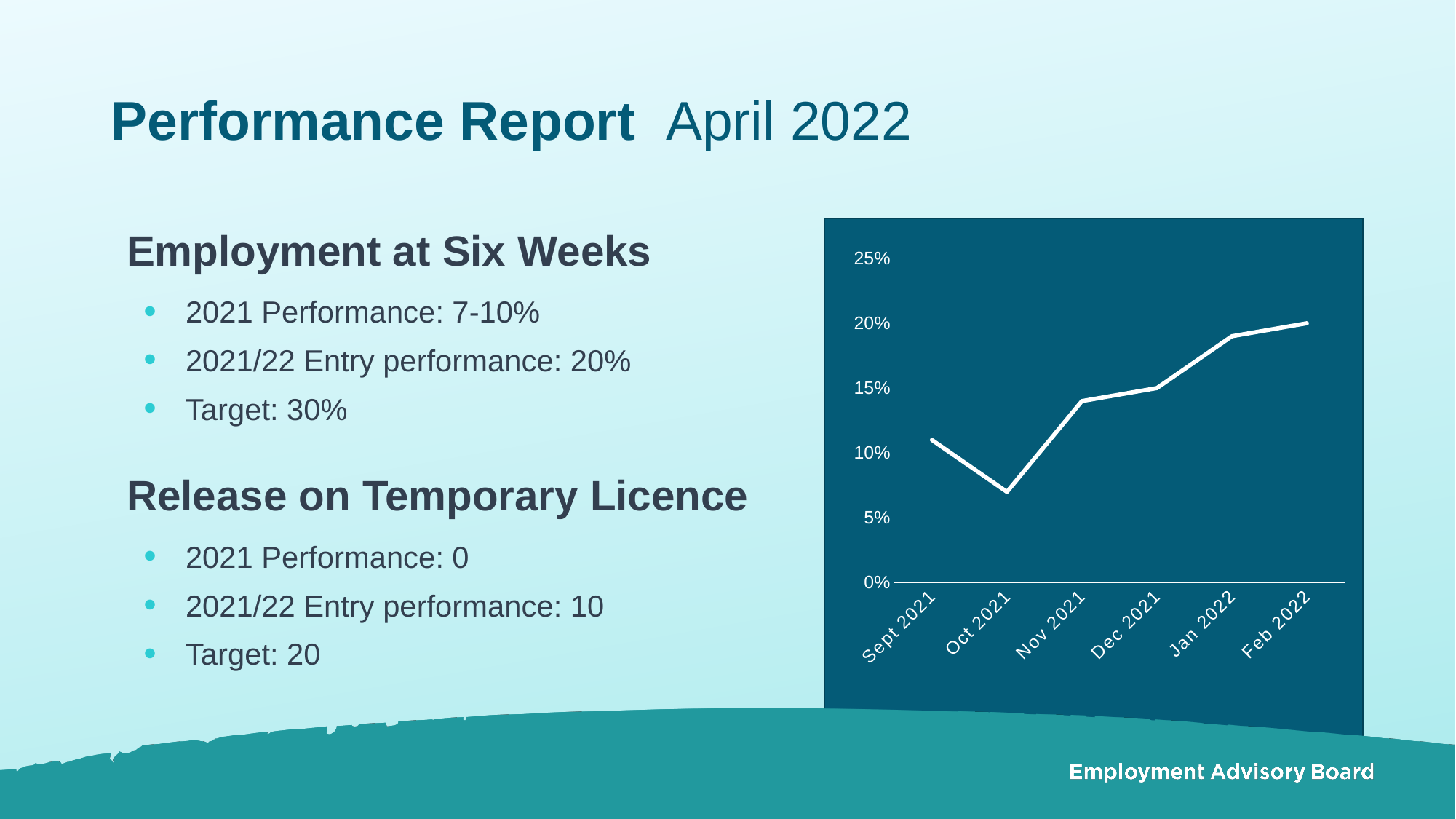
Which month has the highest value on the chart? Feb 2022 How many months are plotted on the x axis of the chart? 6 Is the value for Feb 2022 greater or less than 25%? less Which month has the lowest value on the chart? Oct 2021 What kind of chart is shown on the slide? line chart What is the highest percentage label shown on the chart's y axis? 25% Is the value for Oct 2021 greater or less than 5%? greater Does the line rise or fall from Oct 2021 to Feb 2022? rise Is the value for Jan 2022 greater or less than 15%? greater Which is larger, the value for Nov 2021 or the value for Oct 2021? Nov 2021